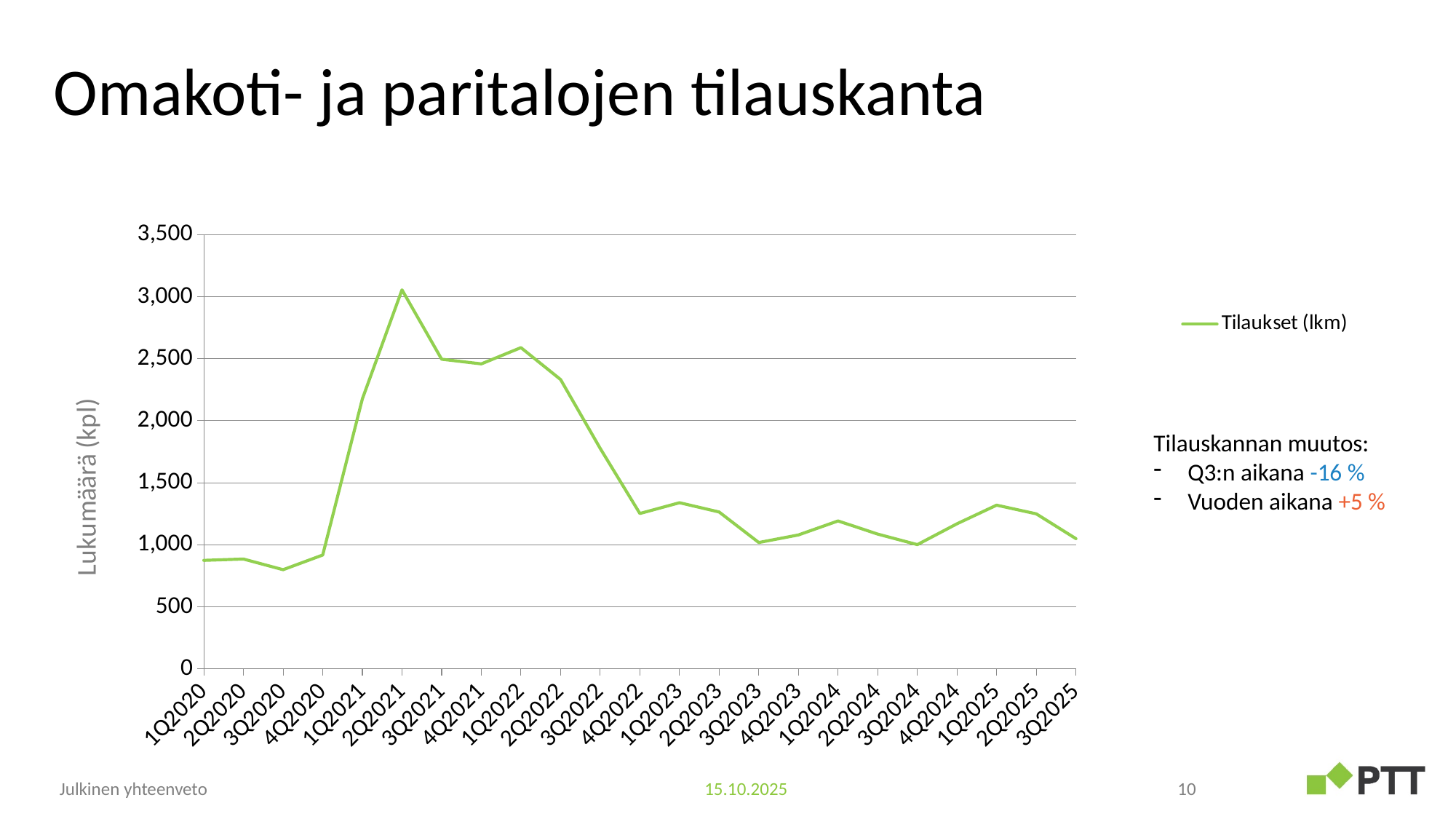
Is the value for 4Q2022 greater or less than 1,500? less How many quarters are plotted along the x axis? 23 How many series does the legend list? 1 Is the value for 2Q2021 greater or less than 3,000? greater Which quarter has the lowest value for Tilaukset (lkm)? 3Q2020 What kind of chart is shown on the slide? line chart What is the title of the y axis? Lukumäärä (kpl) Is the value for 3Q2020 greater or less than 1,000? less Which quarter has the highest value for Tilaukset (lkm)? 2Q2021 Which is larger, the value for 1Q2025 or the value for 3Q2025? 1Q2025 Do the values rise or fall from 2Q2021 to 4Q2022? fall